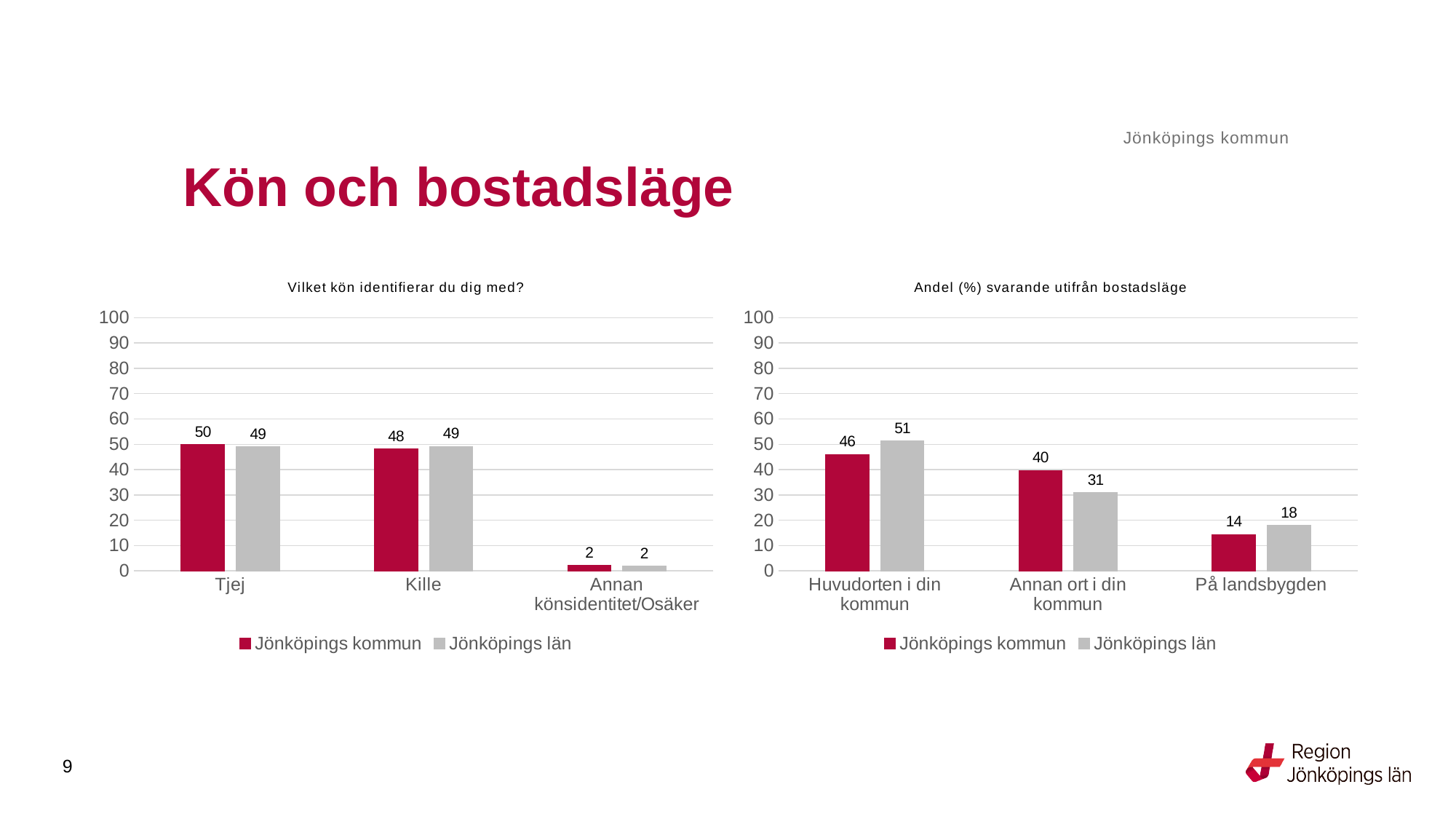
In the chart titled "Andel (%) svarande utifrån bostadsläge", what is the value for Huvudorten i din kommun for Jönköpings län? 51 In the chart titled "Vilket kön identifierar du dig med?", what is the value for Kille for Jönköpings län? 49 In the chart titled "Vilket kön identifierar du dig med?", what is the value for Tjej for Jönköpings kommun? 50 In the chart titled "Andel (%) svarande utifrån bostadsläge", which is larger for Annan ort i din kommun: Jönköpings kommun or Jönköpings län? Jönköpings kommun In the chart titled "Andel (%) svarande utifrån bostadsläge", how many series does the legend list? 2 What kind of chart is the chart titled "Vilket kön identifierar du dig med?"? Bar chart In the chart titled "Andel (%) svarande utifrån bostadsläge", which category has the highest value for Jönköpings län? Huvudorten i din kommun In the chart titled "Vilket kön identifierar du dig med?", how many categories are shown on the x axis? 3 In the chart titled "Andel (%) svarande utifrån bostadsläge", what is the value for På landsbygden for Jönköpings kommun? 14 In the chart titled "Vilket kön identifierar du dig med?", what is the value for Annan könsidentitet/Osäker for Jönköpings kommun? 2 In the chart titled "Andel (%) svarande utifrån bostadsläge", what is the difference between Jönköpings kommun and Jönköpings län for Annan ort i din kommun? 9 In the chart titled "Vilket kön identifierar du dig med?", which category has the lowest value for Jönköpings kommun? Annan könsidentitet/Osäker